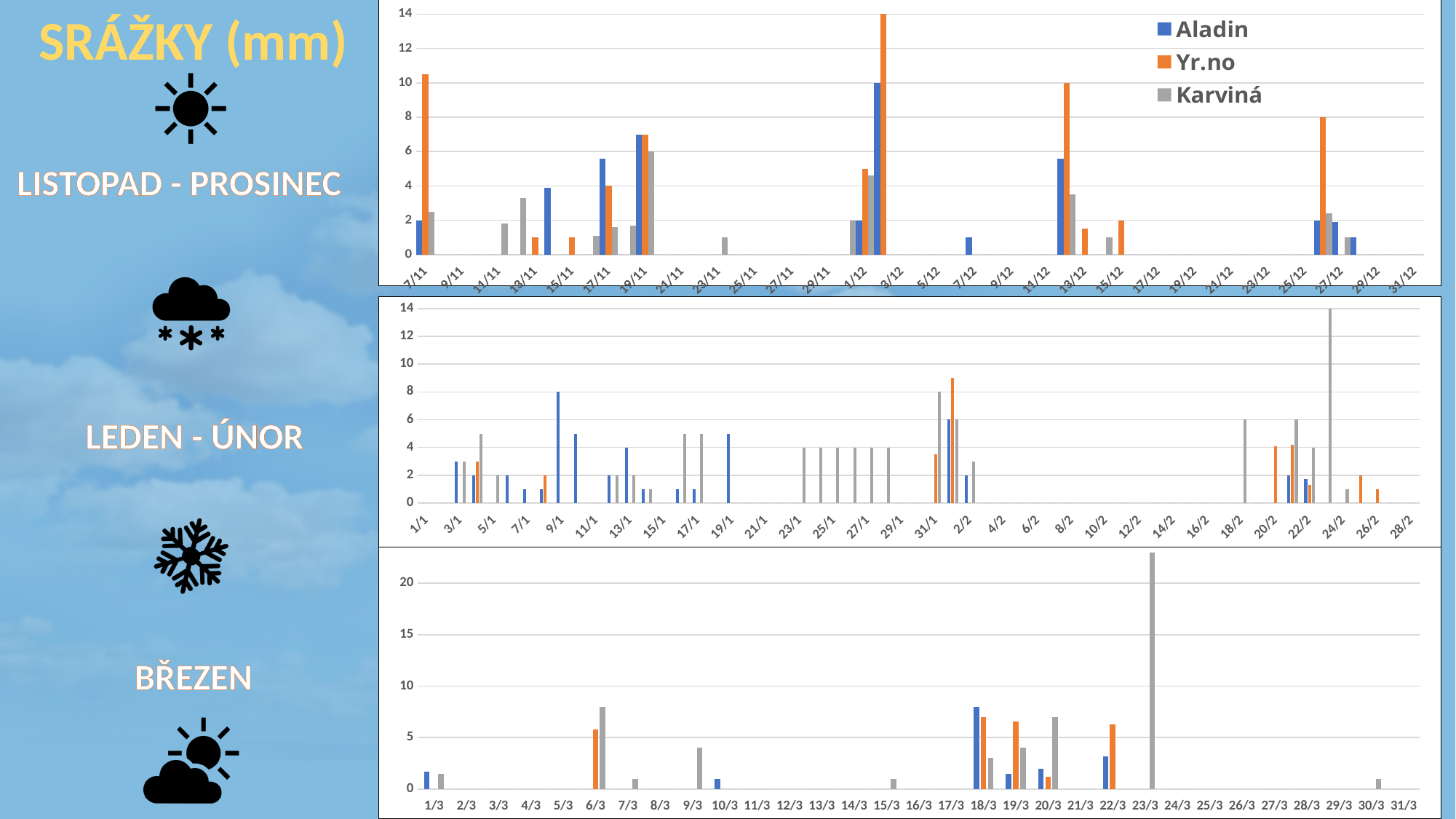
In the top chart (Listopad - Prosinec), which series has the tallest bar on 3/12? Yr.no In the bottom chart (Březen), on 19/3 which is larger, Yr.no or Aladin? Yr.no In the top chart (Listopad - Prosinec), on 17/11 which is larger, Aladin or Yr.no? Aladin How many series does the legend on the top chart list? 3 In the bottom chart (Březen), is the Karviná value on 6/3 greater or less than 5? greater In the bottom chart (Březen), is the Karviná value on 23/3 greater or less than 20? greater What kind of chart is the top chart (Listopad - Prosinec)? bar chart In the top chart (Listopad - Prosinec), is the Karviná value on 13/11 greater or less than 4? less What are the three series named in the legend of the top chart? Aladin, Yr.no, Karviná